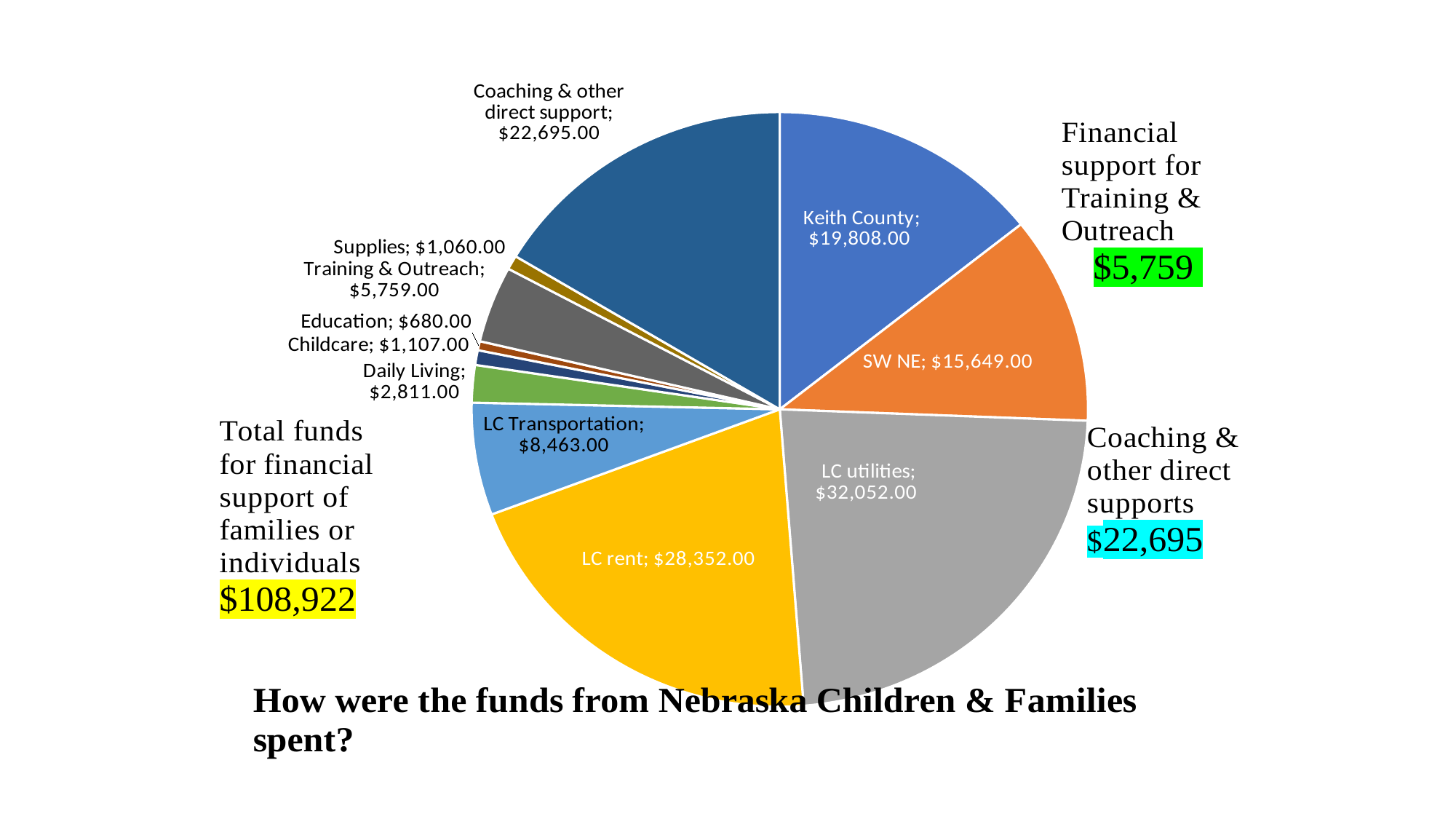
What is the value for LC utilities? $32,052.00 What is the value for Coaching & other direct support? $22,695.00 What is the difference between LC utilities and LC rent? $3,700.00 Which category has the largest slice of the pie? LC utilities What is the difference between Keith County and SW NE? $4,159.00 What kind of chart is shown on the slide? pie chart What is the value for LC Transportation? $8,463.00 Which is larger, LC rent or Keith County? LC rent How many slices does the pie chart have? 11 What is the value for Keith County? $19,808.00 Which category has the smallest slice of the pie? Education What is the title text shown below the chart? How were the funds from Nebraska Children & Families spent?